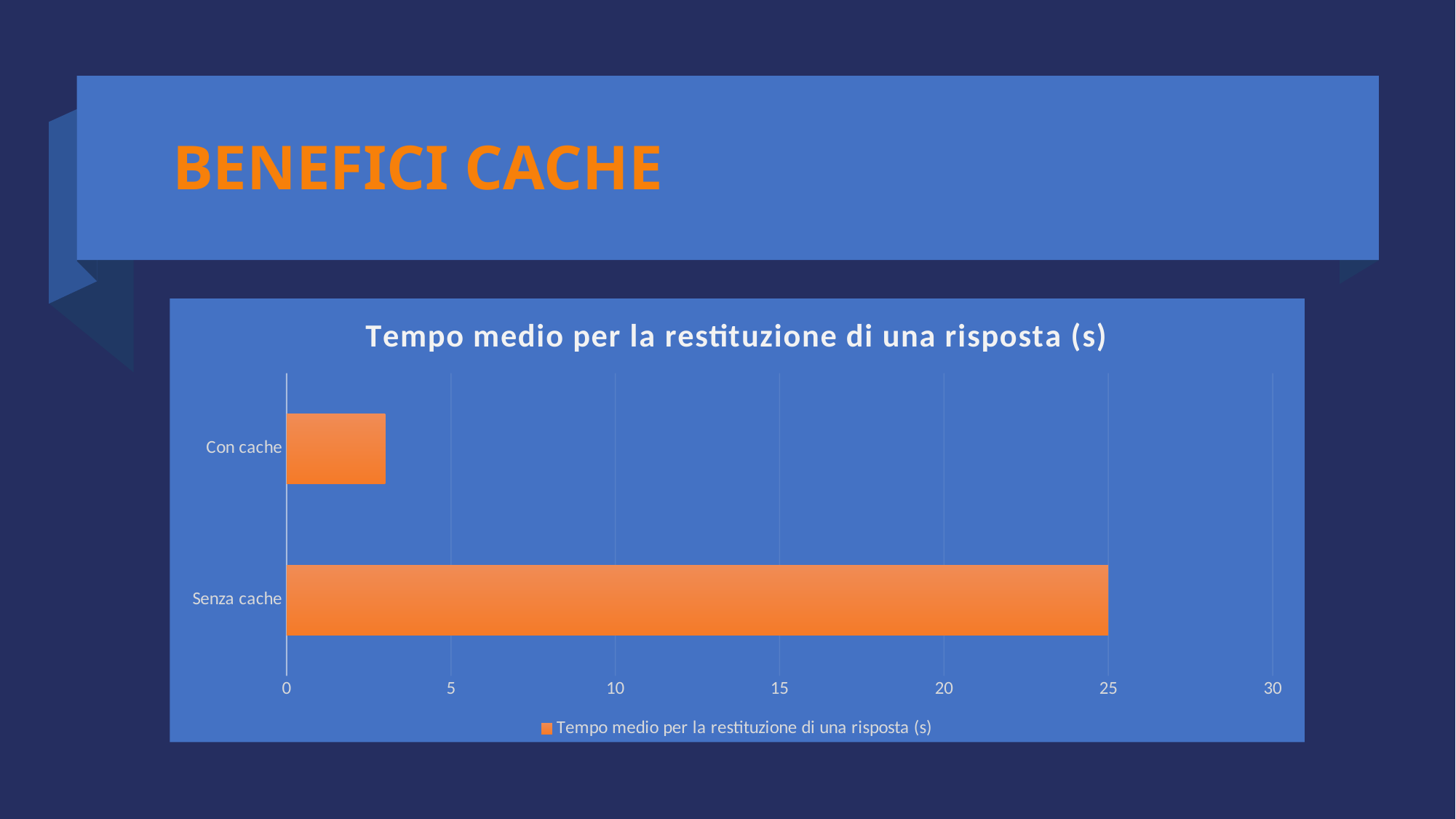
Is the value for Con cache greater or less than 5? less Which is larger, the value for Con cache or the value for Senza cache? Senza cache Is the value for Senza cache greater or less than 20? greater Which category has the highest value? Senza cache What is the name of the series shown in the legend? Tempo medio per la restituzione di una risposta (s) What is the highest value shown on the x axis? 30 What is the title of the chart? Tempo medio per la restituzione di una risposta (s) How many categories are plotted in the chart? 2 Which category has the lowest value? Con cache What kind of chart is shown on the slide? bar chart What is the value for Senza cache? 25 How many series does the legend list? 1